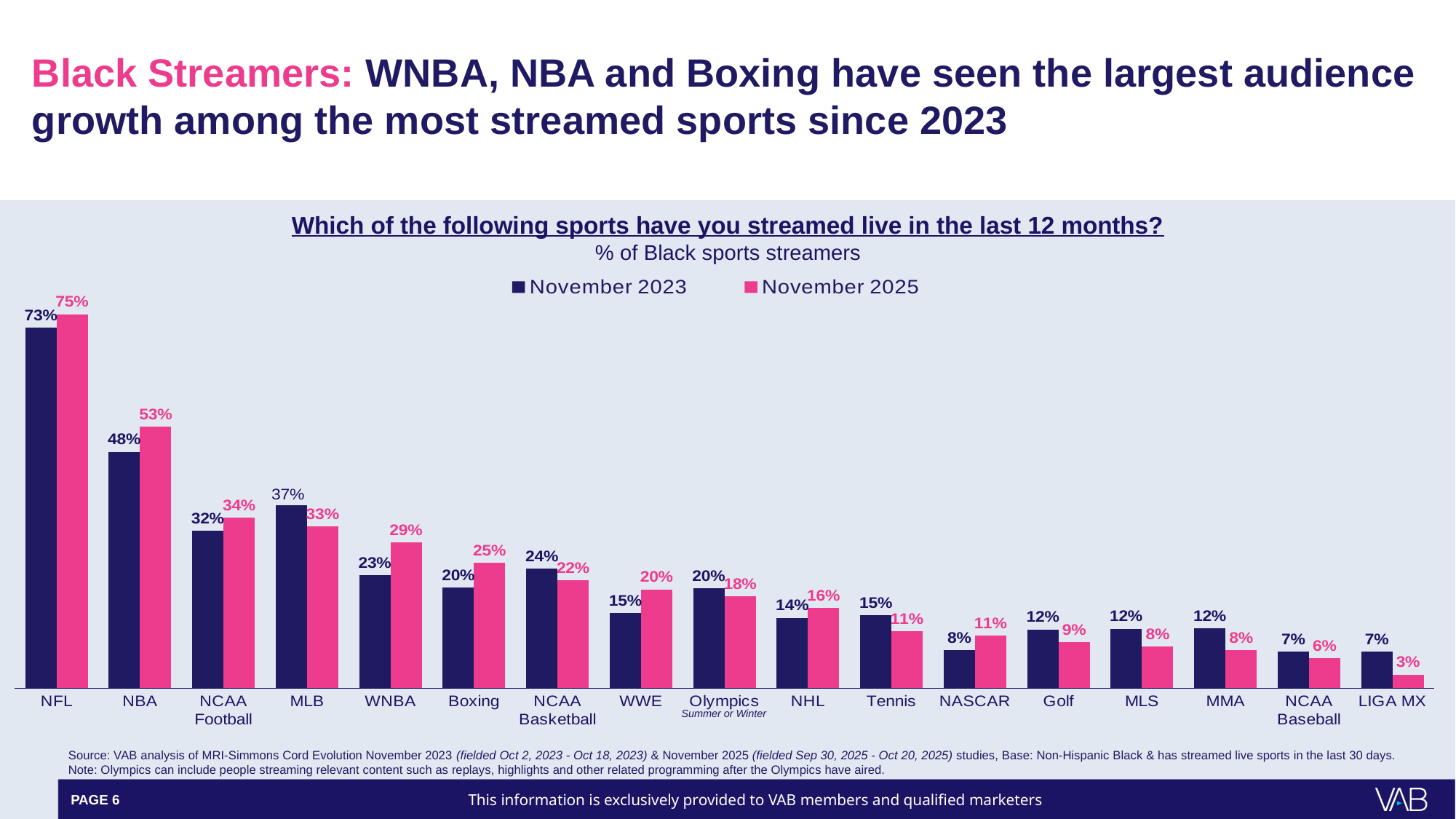
For MLB, which is larger: the November 2023 value or the November 2025 value? November 2023 What was the November 2023 value for MLB? 37% How many series does the legend list? 2 Which sport has the lowest November 2025 value? LIGA MX By how many percentage points did the NBA value change from November 2023 to November 2025? 5 percentage points What percentage of Black sports streamers streamed the WNBA live in November 2025? 29% What type of chart is shown on the slide? Bar chart Which is larger: the November 2025 value for WWE or the November 2025 value for Olympics? WWE Which sport has the highest November 2025 value? NFL How many sports are shown on the x axis of the chart? 17 What is the November 2025 value for LIGA MX? 3% What is the difference between the November 2023 and November 2025 values for Boxing? 5 percentage points